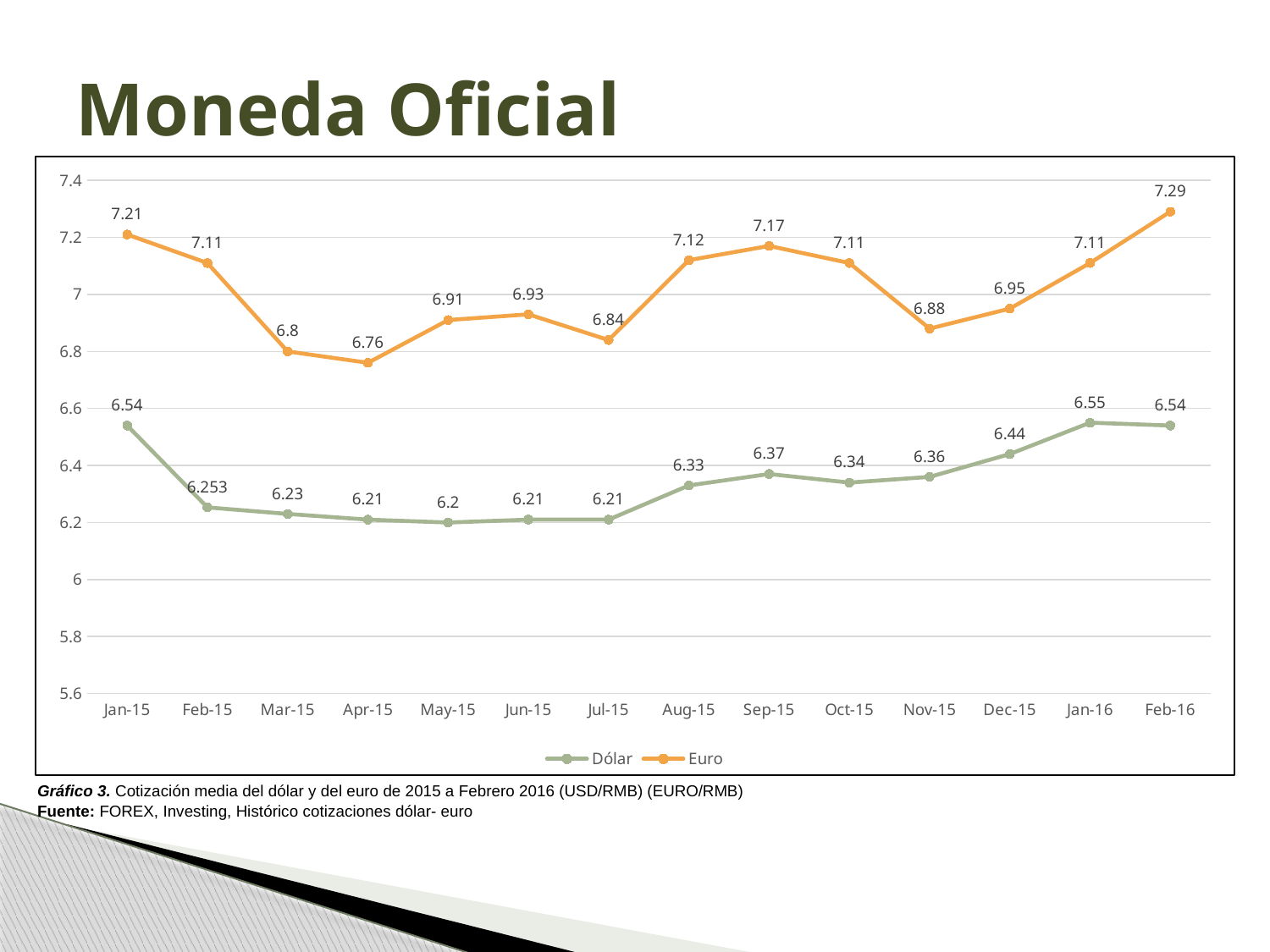
How many months are plotted along the x axis? 14 Does the Dólar value rise or fall from Jul-15 to Jan-16? Rise What is the Euro value for Apr-15? 6.76 In which month is the Dólar value lowest? May-15 How many series does the legend list? 2 What is the difference between the Euro value in Feb-16 and in Jan-15? 0.08 What type of chart is shown on the slide? Line chart In which month is the Euro value lowest? Apr-15 Which is larger in Sep-15, the Euro value or the Dólar value? Euro What is the Euro value for Feb-16? 7.29 In which month is the Euro value highest? Feb-16 What is the Dólar value for Feb-15? 6.253